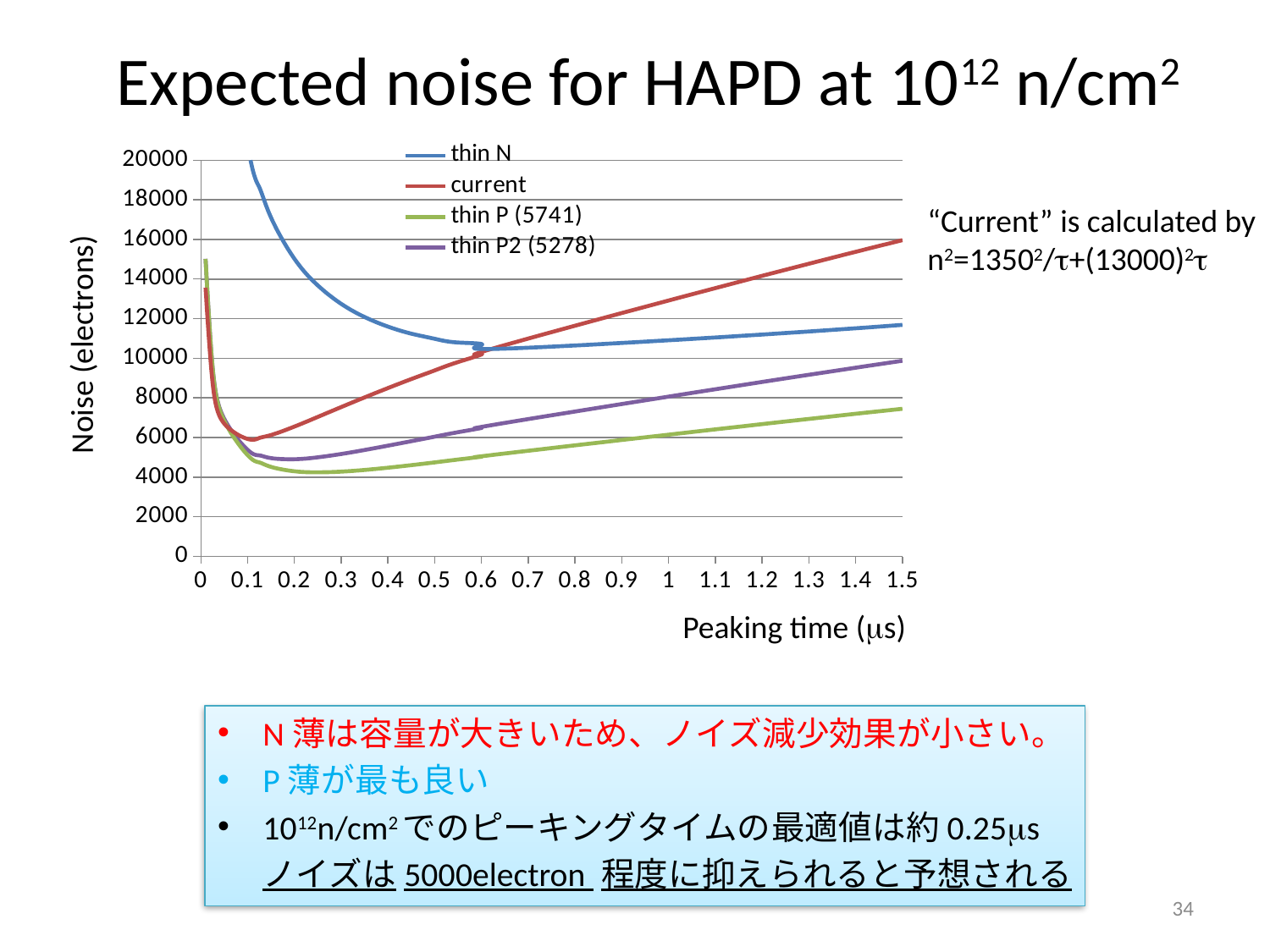
What kind of chart is shown on the slide? line chart Which series has the lowest noise at a peaking time of 1.0? thin P (5741) Is the value of the thin P (5741) series at a peaking time of 1.5 greater or less than 10000? less At a peaking time of 1.0, which series has the higher noise, thin P (5741) or thin P2 (5278)? thin P2 (5278) Which series has the highest noise at a peaking time of 0.3? thin N What are the four series named in the chart legend? thin N, current, thin P (5741), thin P2 (5278) What is the label of the vertical axis of the chart? Noise (electrons) Is the value of the thin P2 (5278) series at a peaking time of 0.2 greater or less than 6000? less How many series does the chart legend list? 4 At a peaking time of 1.5, which series has the higher noise, current or thin N? current Is the value of the thin N series at a peaking time of 1.5 greater or less than 10000? greater